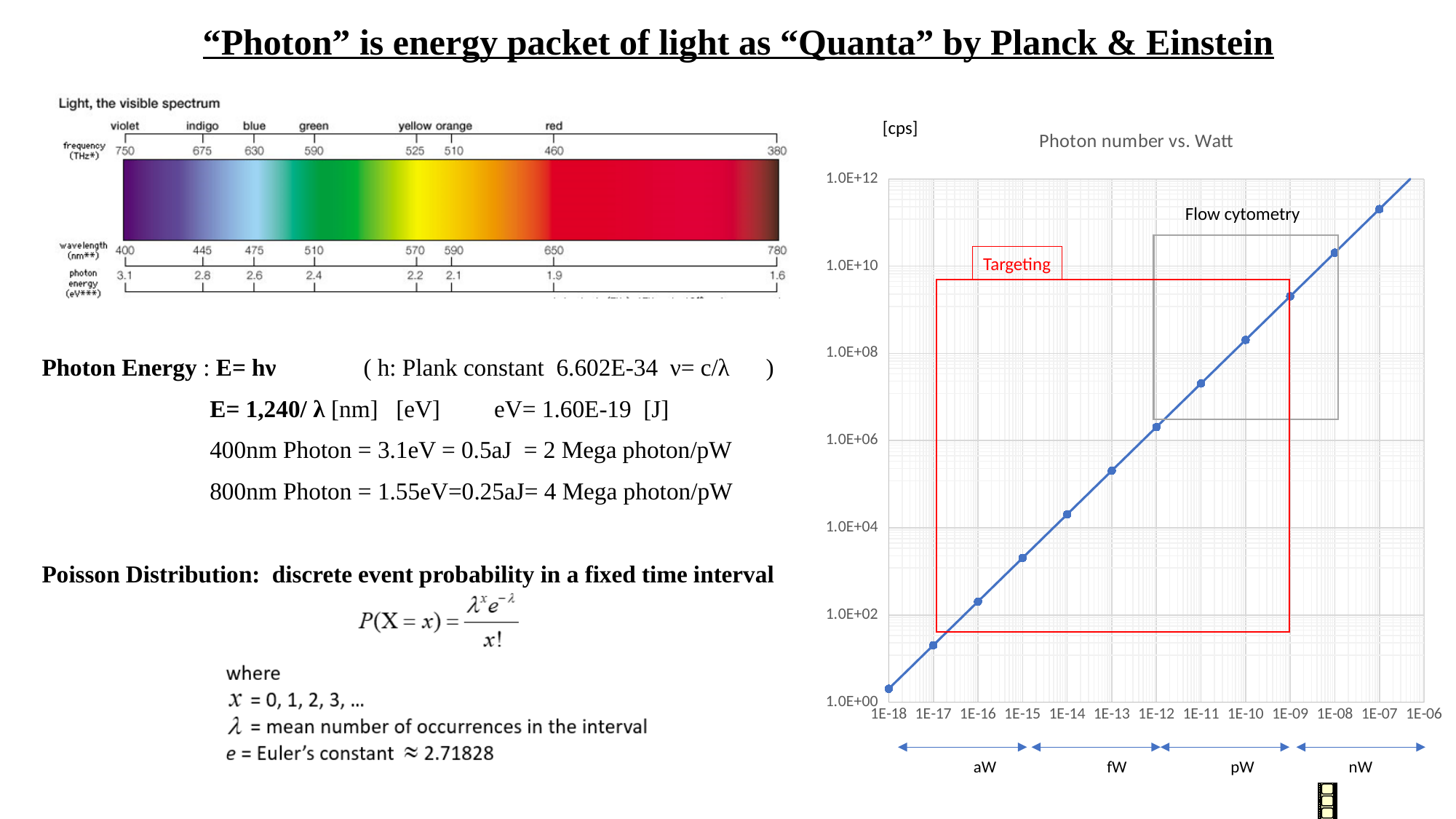
In the "Photon number vs. Watt" chart, is the value at 1E-14 greater or less than 1.0E+02? greater In the "Photon number vs. Watt" chart, do the values rise or fall as the x axis goes from 1E-18 to 1E-06? rise What kind of chart is the "Photon number vs. Watt" chart? line chart In the "Photon number vs. Watt" chart, is the value at 1E-10 greater or less than 1.0E+10? less How many power-unit bands (aW, fW, pW, nW) are marked below the x axis of the "Photon number vs. Watt" chart? 4 In the "Photon number vs. Watt" chart, is the value at 1E-17 greater or less than 1.0E+02? less What is the highest tick label on the y axis of the "Photon number vs. Watt" chart? 1.0E+12 What is the title of the chart on the right of the slide? Photon number vs. Watt In the "Photon number vs. Watt" chart, which has the larger value, 1E-08 or 1E-12? 1E-08 What unit is shown for the y axis of the "Photon number vs. Watt" chart? [cps]